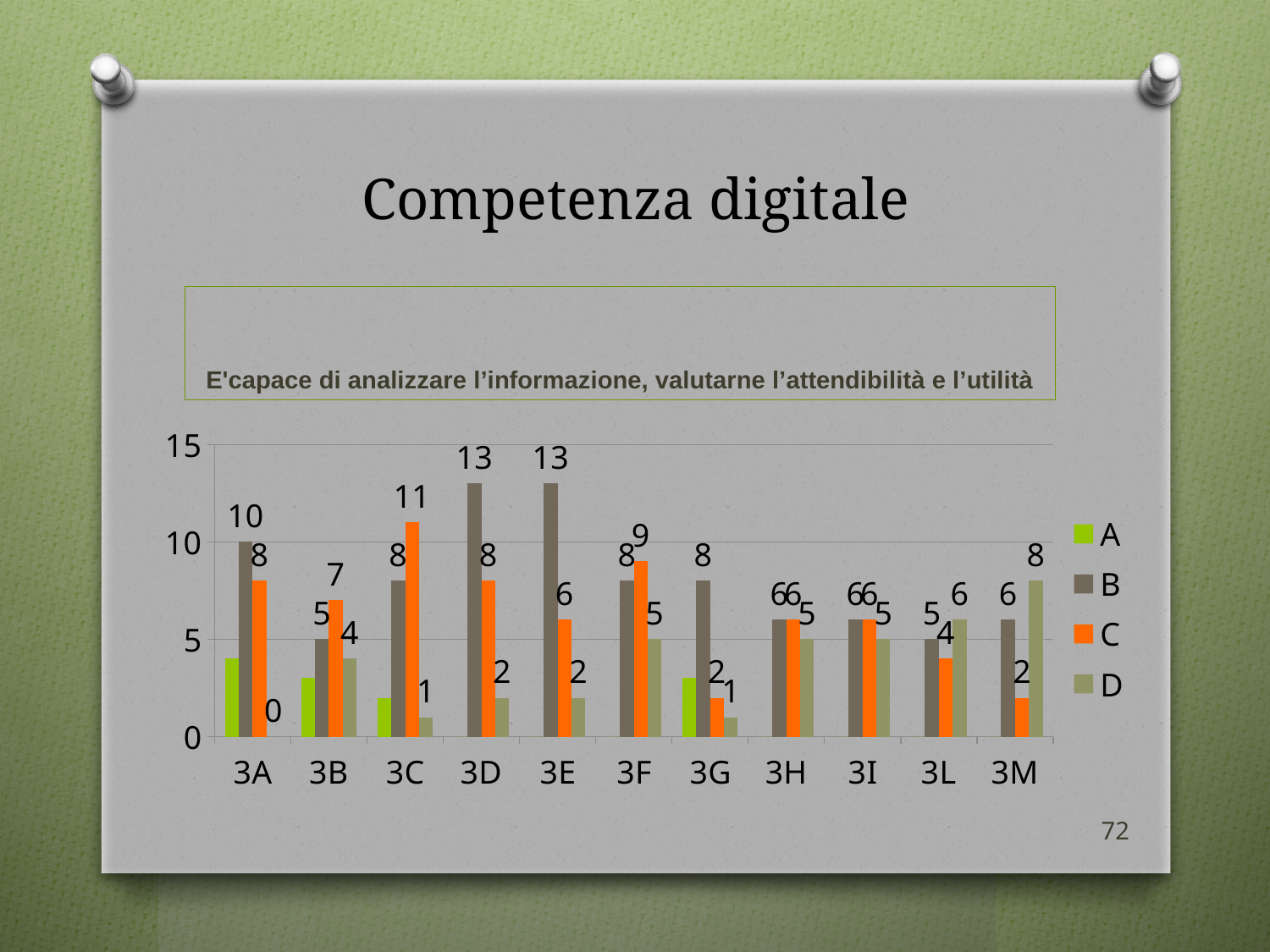
How many categories are shown on the x axis? 11 How many series does the legend list? 4 What is the value of series B for category 3D? 13 What is the value of series D for category 3M? 8 For category 3A, what is the difference between the values of series B and series C? 2 Which category has the lowest value for series D? 3A Which category has the highest value for series C? 3C What is the value of series C for category 3C? 11 What is the value of series D for category 3A? 0 Is the value of series A for category 3A greater or less than 5? less For category 3F, which series has the larger value, B or C? C What kind of chart is shown on the slide? bar chart